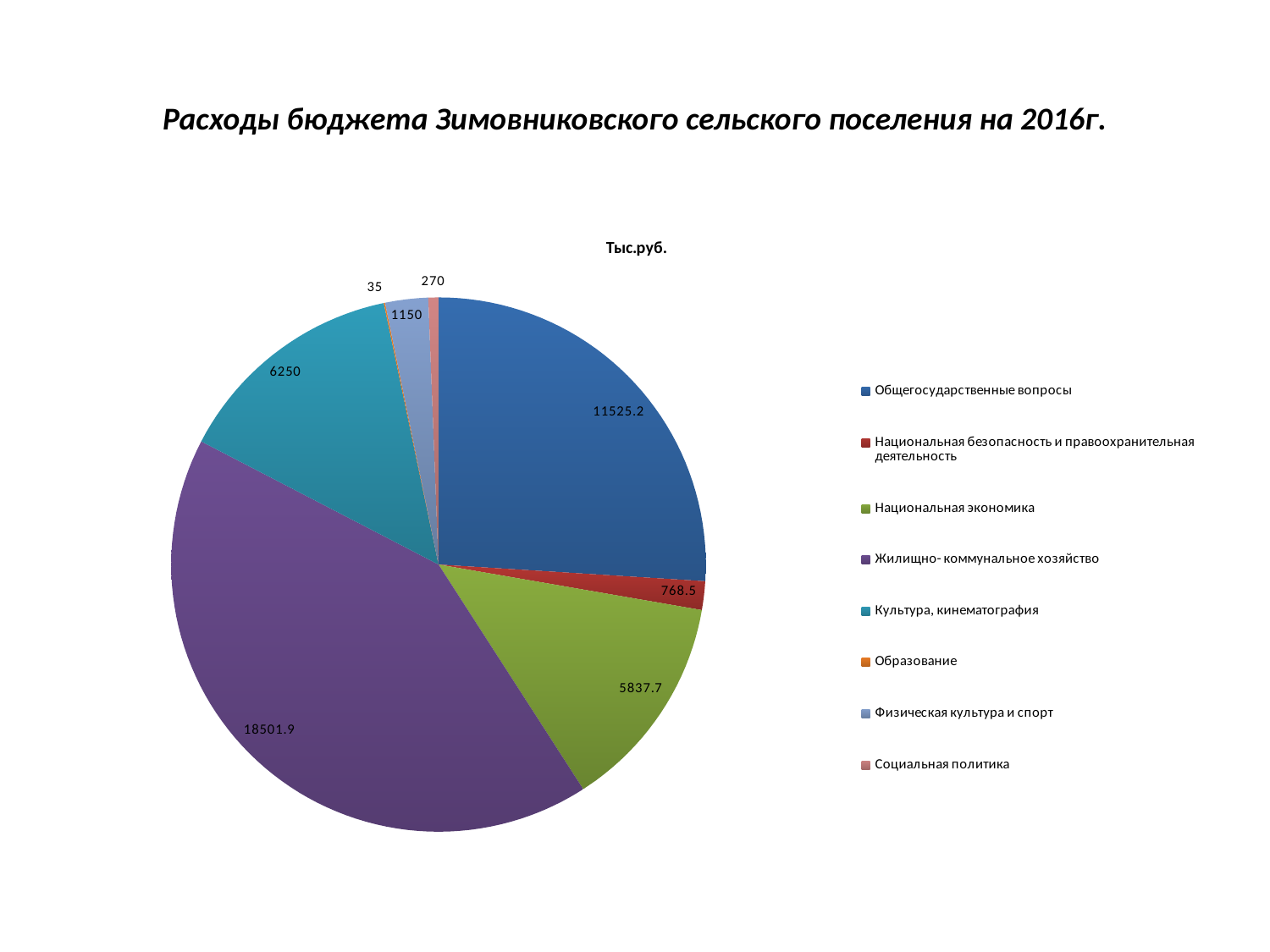
What is the difference between the values for Жилищно- коммунальное хозяйство and Общегосударственные вопросы? 6976.7 What is the value for Общегосударственные вопросы? 11525.2 What is the difference between the values for Физическая культура и спорт and Социальная политика? 880 Which is larger, the value for Культура, кинематография or the value for Национальная экономика? Культура, кинематография Which category has the largest slice of the pie? Жилищно- коммунальное хозяйство How many categories does the legend list? 8 What is the value for Жилищно- коммунальное хозяйство? 18501.9 What is the value for Образование? 35 What is the title shown above the pie chart? Тыс.руб. Which category has the smallest slice of the pie? Образование What is the value for Национальная безопасность и правоохранительная деятельность? 768.5 What type of chart is shown on the slide? pie chart